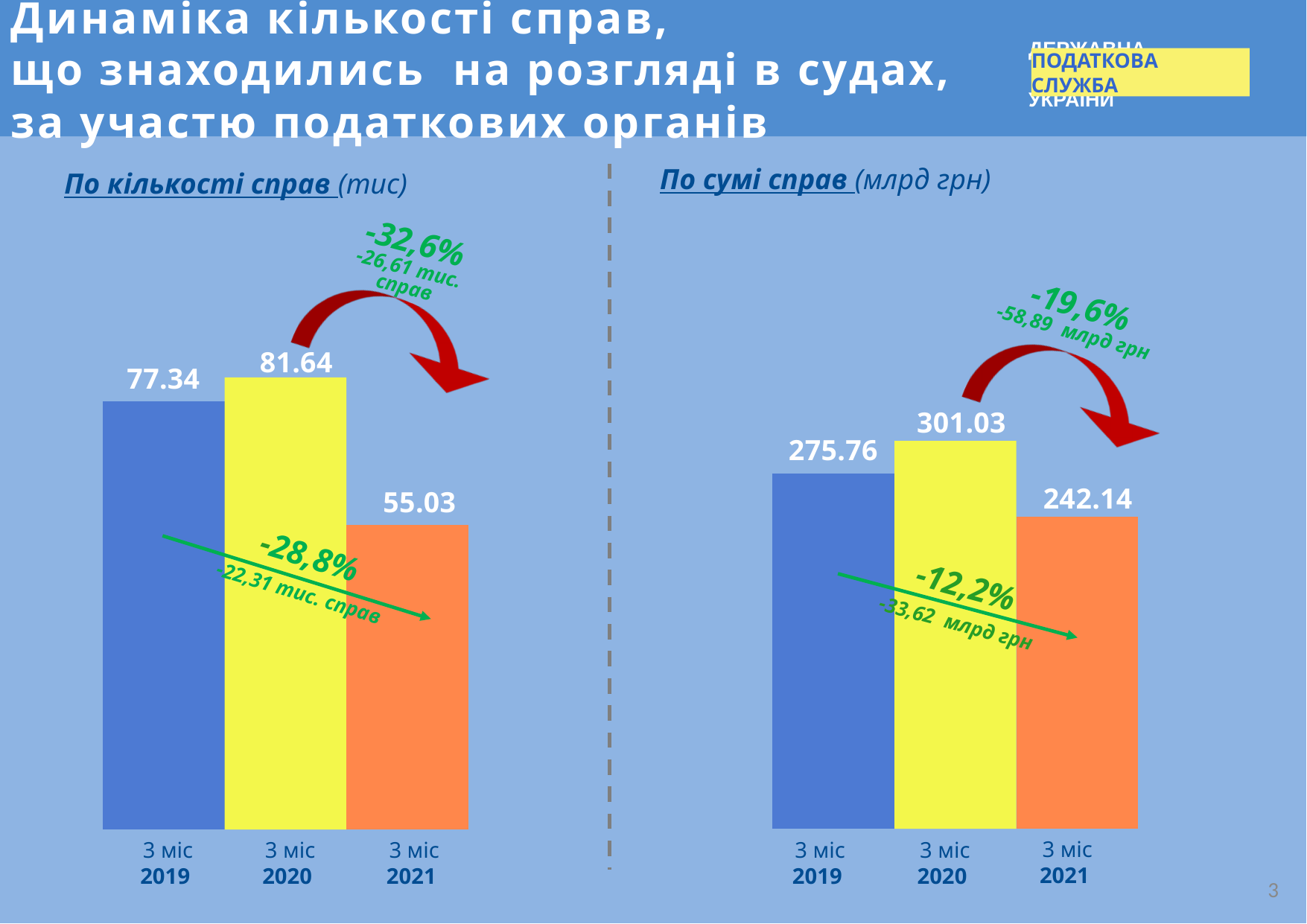
In the left chart 'По кількості справ (тис)', which period has the highest value? 3 міс 2020 In the left chart 'По кількості справ (тис)', what is the value for 3 міс 2021? 55.03 In the left chart 'По кількості справ (тис)', what percentage change is shown between 3 міс 2020 and 3 міс 2021? -32,6% What kind of chart is the right chart 'По сумі справ (млрд грн)'? bar chart In the right chart 'По сумі справ (млрд грн)', which is larger: the value for 3 міс 2019 or 3 міс 2020? 3 міс 2020 In the left chart 'По кількості справ (тис)', what is the value for 3 міс 2020? 81.64 In the right chart 'По сумі справ (млрд грн)', which period has the lowest value? 3 міс 2021 How many bars are in the left chart 'По кількості справ (тис)'? 3 In the right chart 'По сумі справ (млрд грн)', what is the value for 3 міс 2019? 275.76 In the right chart 'По сумі справ (млрд грн)', what is the difference between the values for 3 міс 2019 and 3 міс 2021? 33.62 In the left chart 'По кількості справ (тис)', what is the difference between the values for 3 міс 2020 and 3 міс 2021? 26.61 In the right chart 'По сумі справ (млрд грн)', what is the value for 3 міс 2021? 242.14